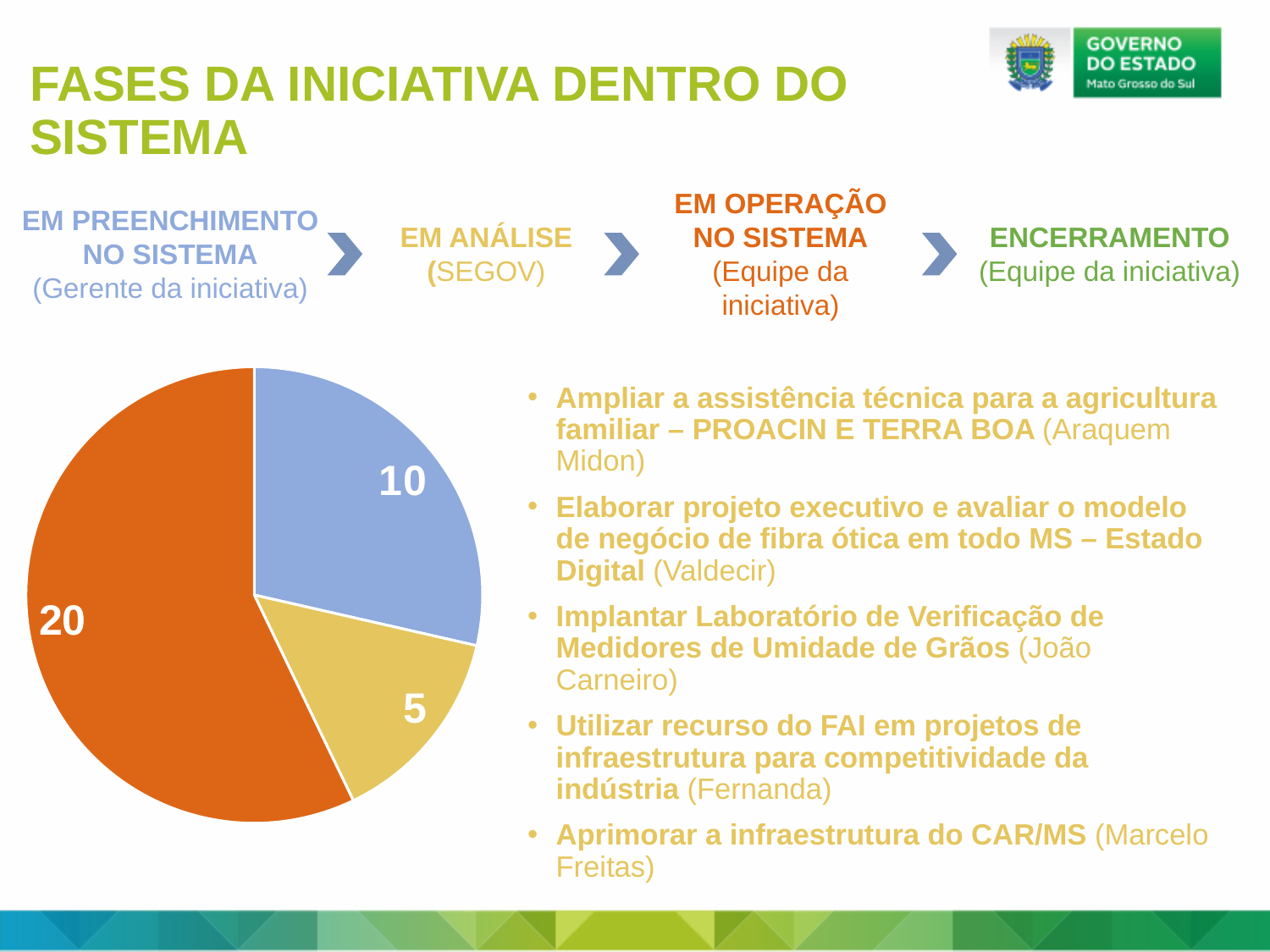
What is the difference between the blue slice and the yellow slice in the pie chart? 5 How many slices does the pie chart have? 3 Which is larger in the pie chart, the blue slice or the yellow slice? the blue slice Which slice of the pie chart has the smallest value? the yellow slice (5) What is the value of the yellow slice of the pie chart? 5 What is the value of the blue slice of the pie chart? 10 What is the difference between the orange slice and the blue slice in the pie chart? 10 What kind of chart is shown on the slide? pie chart What is the value of the orange slice of the pie chart? 20 Does the pie chart have a legend? No Which slice of the pie chart has the largest value? the orange slice (20) What is the total of all the values shown in the pie chart? 35